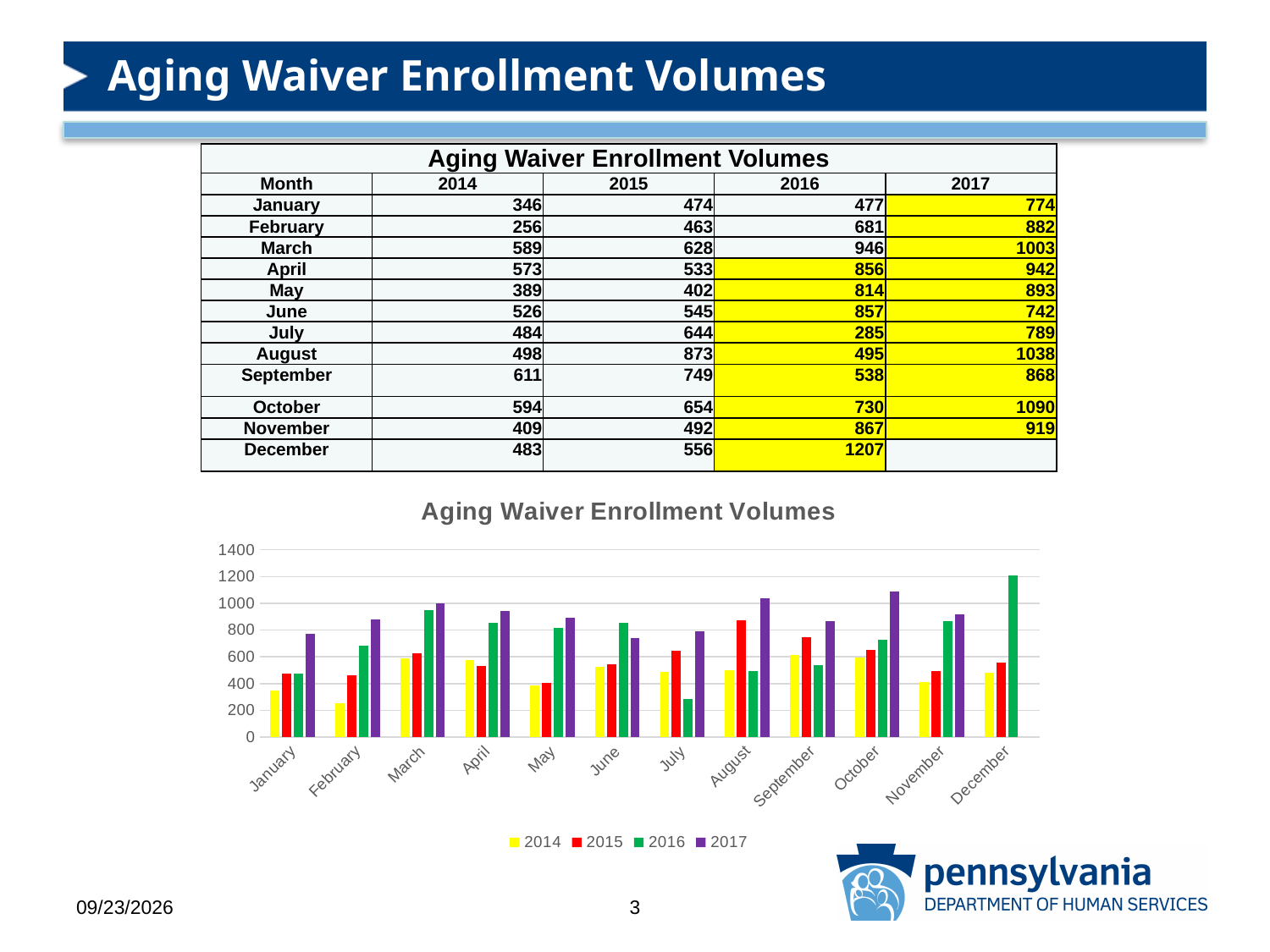
Which month and year has the tallest bar in the chart? December 2016 How many series does the chart's legend list? 4 What is the enrollment volume for August 2015? 873 What is the difference between the March 2017 value and the March 2014 value? 414 Which month has the lowest value for the 2014 series? February What colour represents the 2017 series in the chart? purple Is the value for July 2016 greater or less than 400? less How many months are shown along the x axis of the chart? 12 Which is larger, the July value for 2016 or for 2017? 2017 Is the value for October 2017 greater or less than 1000? greater What kind of chart is shown on the slide? bar chart What is the Aging Waiver enrollment volume for December 2016? 1207